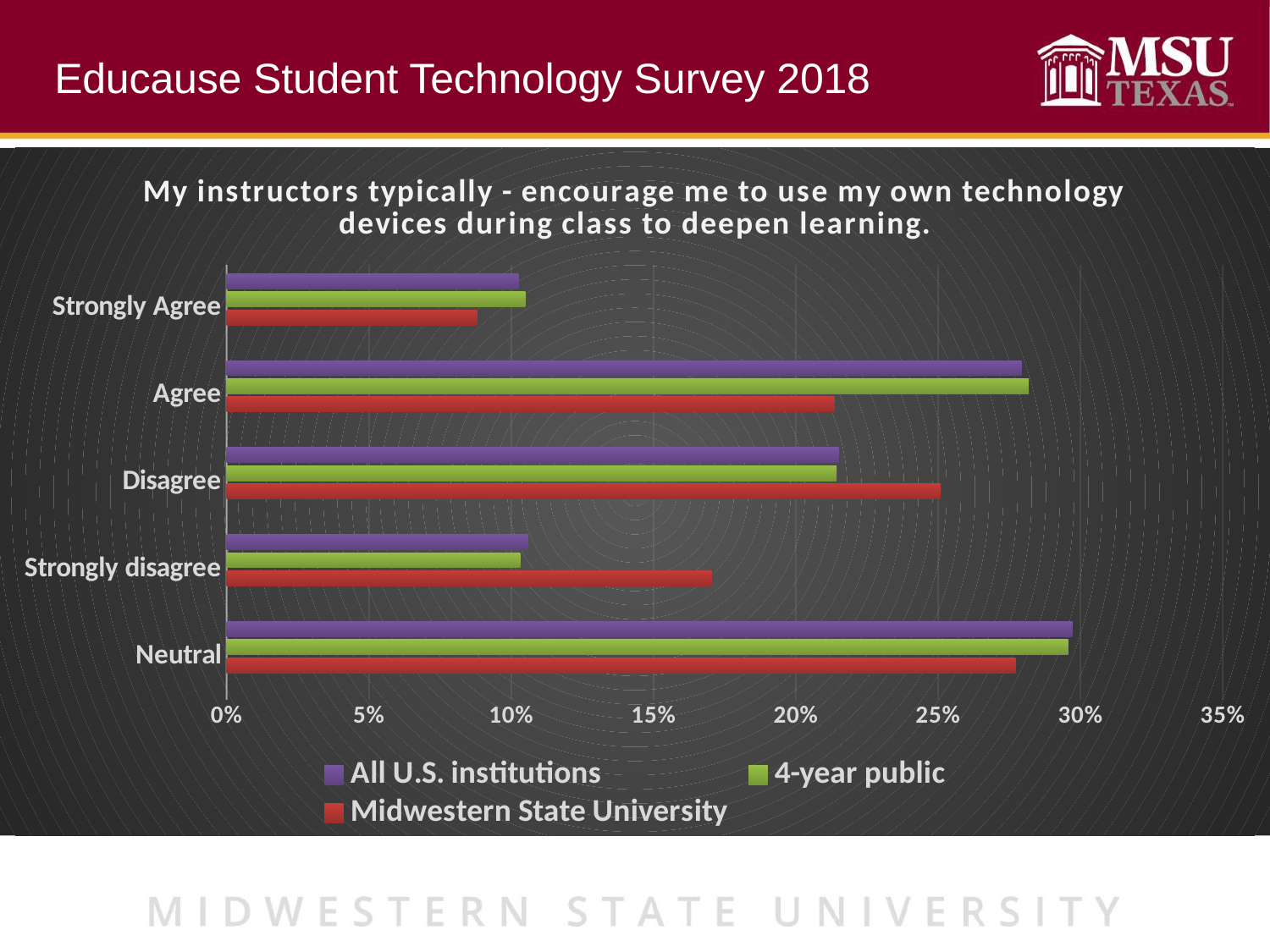
How many series does the legend list? 3 Is the value for All U.S. institutions in the Neutral category greater or less than 25%? greater What kind of chart is shown on the slide? Bar chart Is the value for Midwestern State University in the Agree category greater or less than 25%? less In the Agree category, which is larger: All U.S. institutions or Midwestern State University? All U.S. institutions Which series is shown in red in the legend? Midwestern State University Which category has the lowest value for Midwestern State University? Strongly Agree In the Strongly disagree category, which is larger: Midwestern State University or All U.S. institutions? Midwestern State University Which category has the highest value for Midwestern State University? Neutral How many response categories are shown on the chart? 5 Is the value for Midwestern State University in the Strongly disagree category greater or less than 15%? greater